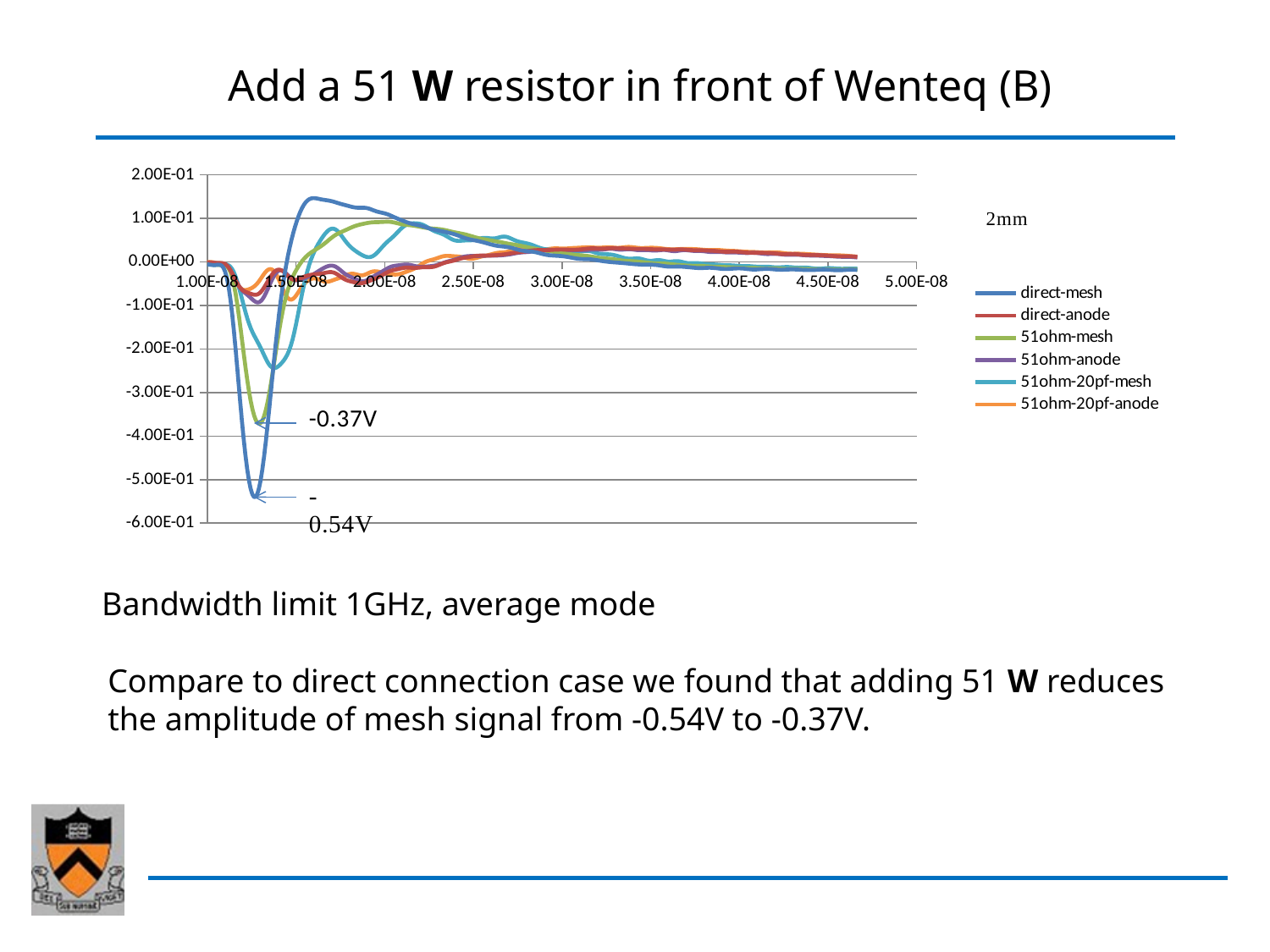
What is the annotated minimum value of the 51ohm-mesh signal? -0.37V Is the minimum value of the 51ohm-20pf-mesh series greater or less than -2.00E-01? less How many series does the chart legend list? 6 Is the positive peak of the direct-mesh series greater or less than 1.00E-01? greater Which series dips lower, direct-mesh or 51ohm-mesh? direct-mesh What is the highest value labelled on the vertical axis? 2.00E-01 Which series reaches the lowest value on the chart? direct-mesh What kind of chart is shown on the slide? line chart What is the annotated minimum value of the direct-mesh signal? -0.54V By how much does the annotated mesh signal amplitude change from the direct connection (-0.54V) to the 51 ohm case (-0.37V)? 0.17V What is the last entry listed in the chart legend? 51ohm-20pf-anode Is the minimum value of the direct-mesh series greater or less than -5.00E-01? less